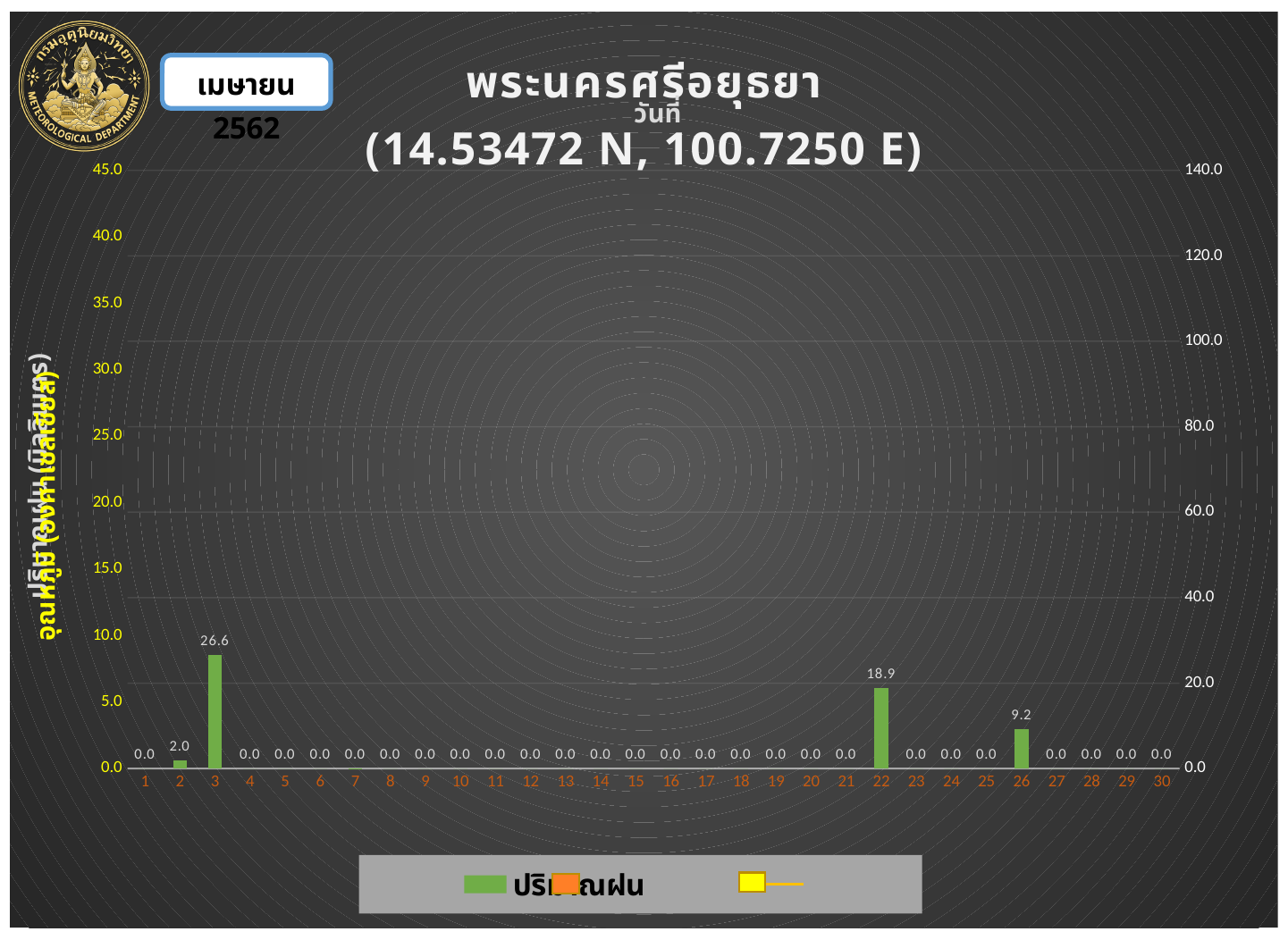
Which day has the highest rainfall value? 3 What is the difference between the rainfall values for day 3 and day 22? 7.7 What is the rainfall value shown for day 15? 0.0 What is the rainfall value shown for day 3? 26.6 What kind of chart is used to show the rainfall values? bar chart What colour are the rainfall (ปริมาณฝน) bars in the chart? green Which day has a larger rainfall value, day 22 or day 26? 22 What is the rainfall value shown for day 26? 9.2 What is the rainfall value shown for day 2? 2.0 What is the rainfall value shown for day 22? 18.9 How many days are shown on the x axis of the chart? 30 What is the difference between the rainfall values for day 22 and day 26? 9.7